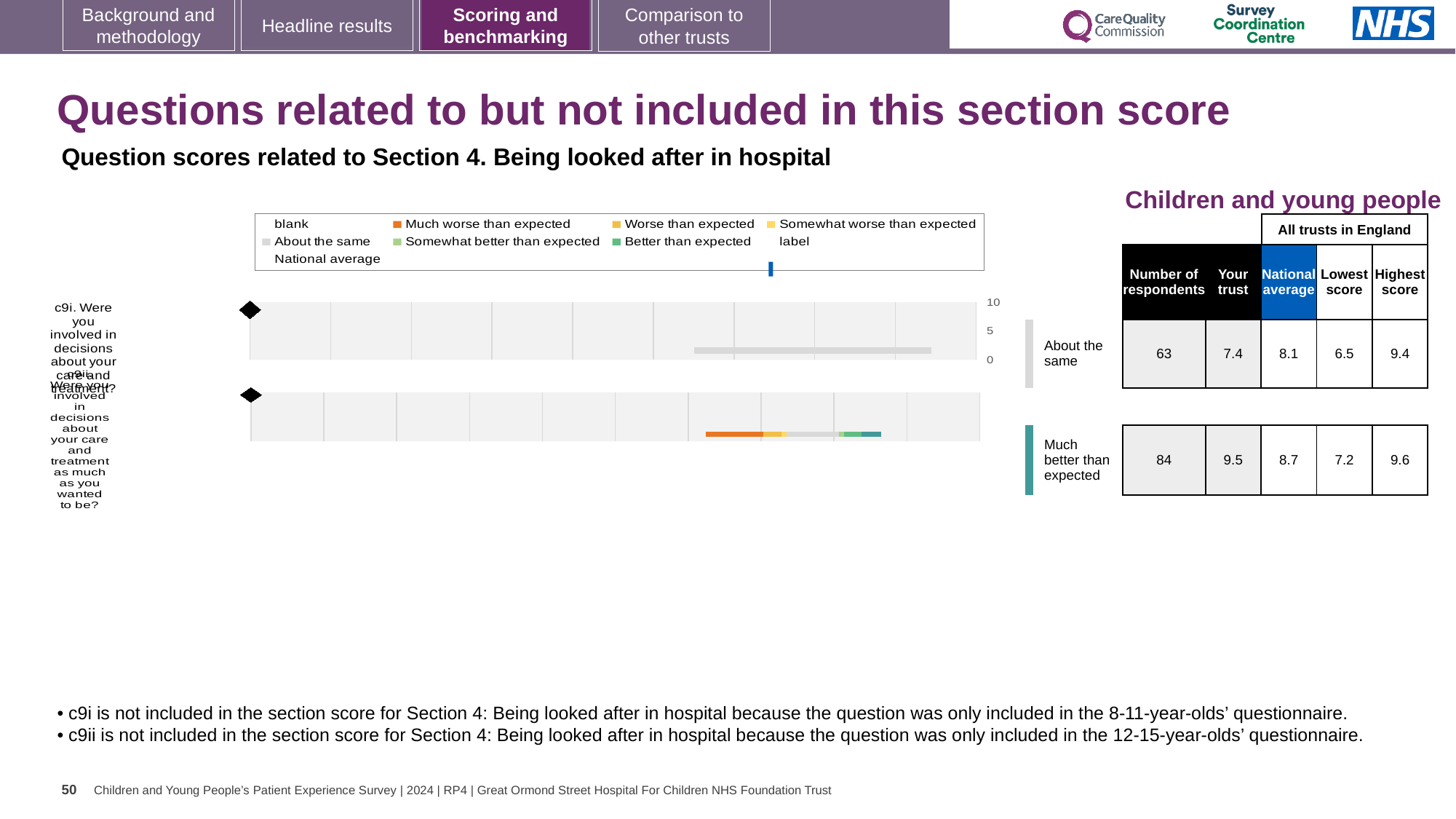
By how much does the trust's score for c9ii exceed the national average for c9ii? 0.8 What benchmark category is shown for question c9ii? Much better than expected What type of chart is shown on the slide? Bar chart What is the lowest score among all trusts in England for question c9i? 6.5 What is the highest score among all trusts in England for question c9ii? 9.6 What is the 'Your trust' score for question c9i? 7.4 What is the national average score for question c9ii? 8.7 What is the difference between the highest and lowest scores for question c9i? 2.9 How many questions are plotted in the chart? 2 Which question has the higher national average, c9i or c9ii? c9ii Which question has the higher 'Your trust' score, c9i or c9ii? c9ii How many respondents answered question c9i? 63